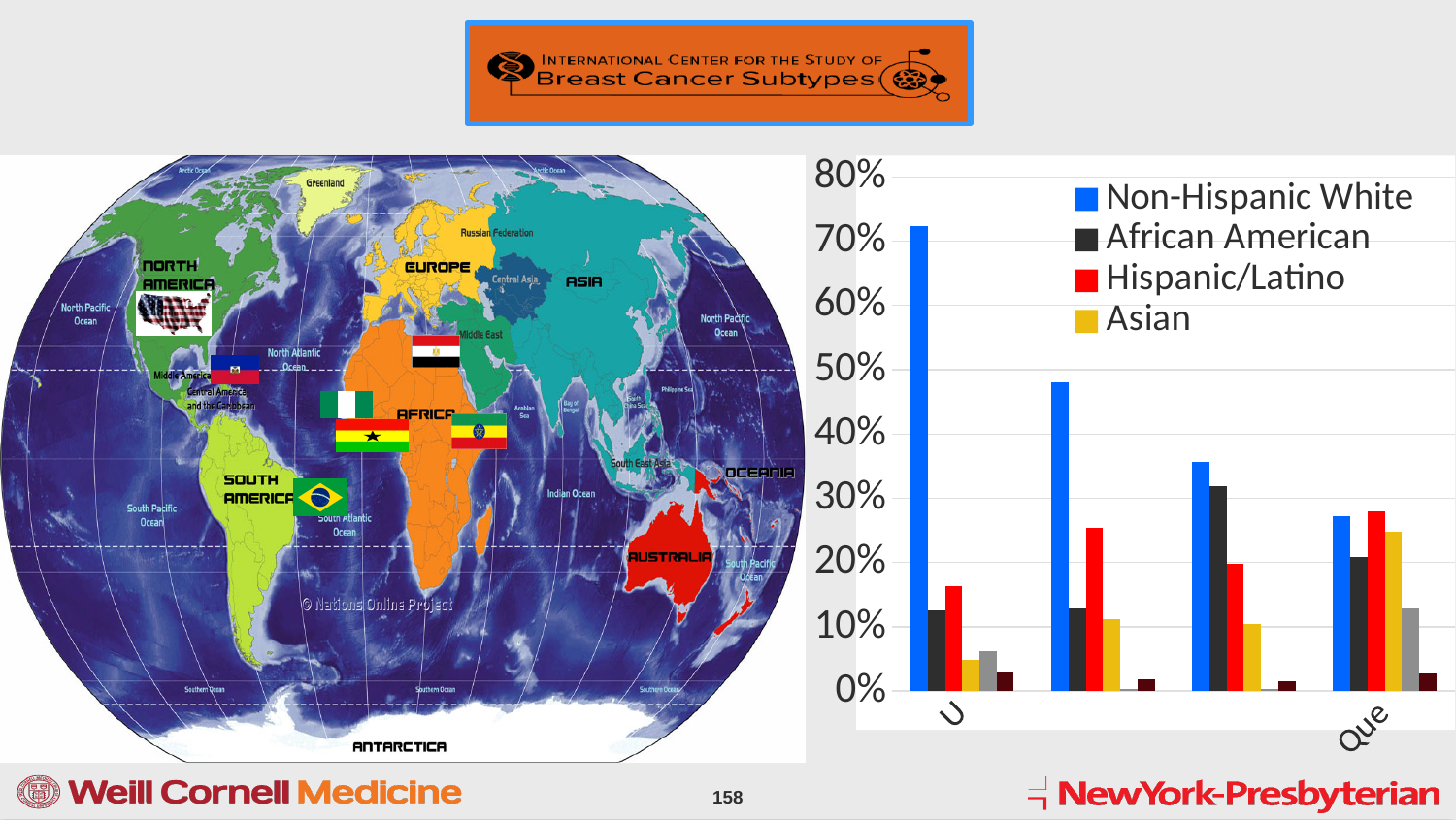
How many groups of bars are plotted along the x axis of the chart? 4 In the first (leftmost) group of bars, which is larger: Non-Hispanic White or African American? Non-Hispanic White In the first (leftmost) group of bars, is the value for Non-Hispanic White greater or less than 70%? greater How many series does the chart's legend list? 4 In the second group of bars from the left, is the value for Non-Hispanic White greater or less than 50%? less In the third group of bars from the left, is the value for African American greater or less than 20%? greater What kind of chart is shown on the right side of the slide? bar chart What colour does the legend use for the Asian series? yellow Do the Non-Hispanic White bars rise or fall from the leftmost group to the rightmost group? fall In the third group of bars from the left, which is larger: Non-Hispanic White or Asian? Non-Hispanic White